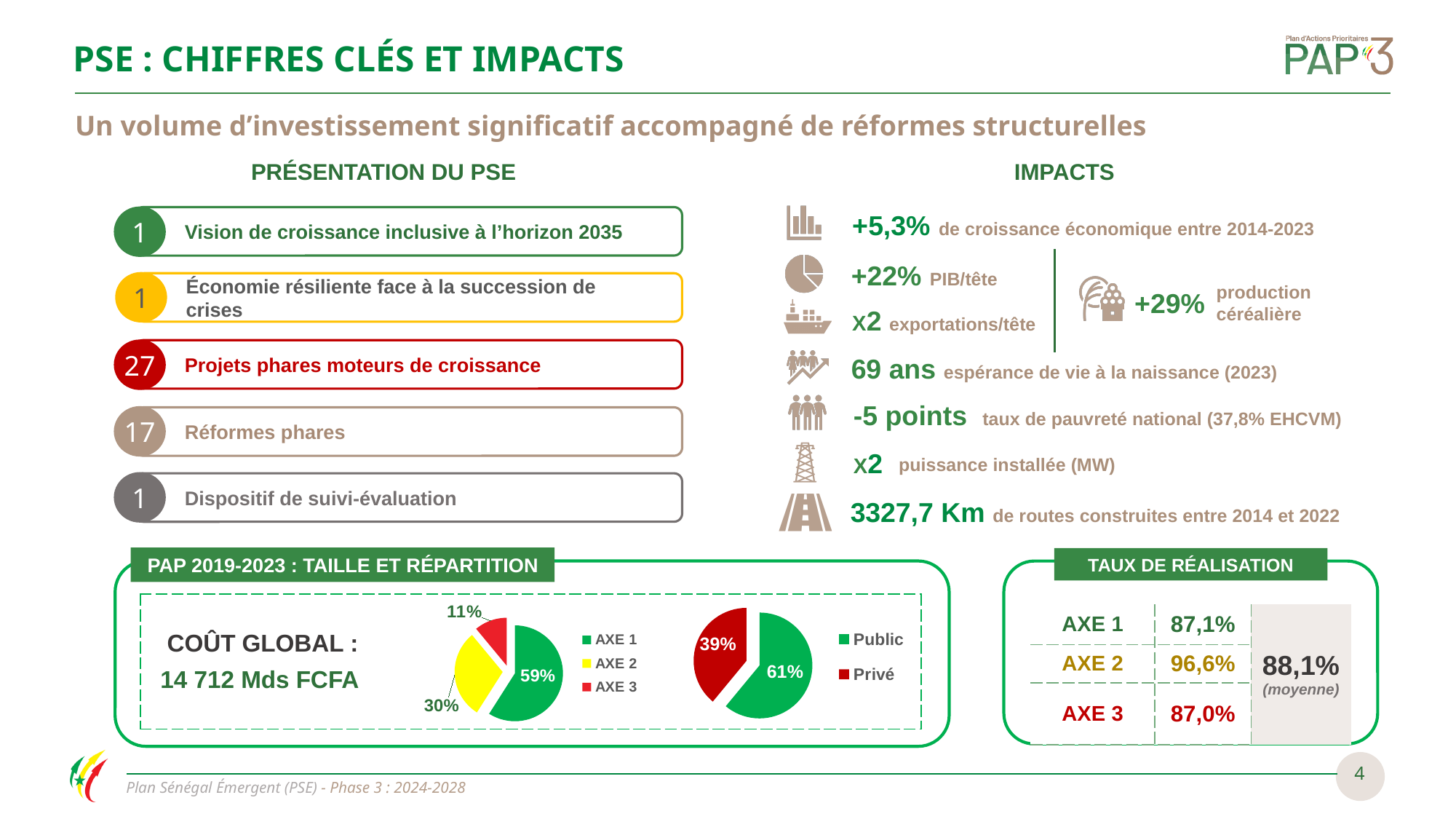
In the right pie chart (Public / Privé), what share is Privé? 39% In the left pie chart under 'PAP 2019-2023 : TAILLE ET RÉPARTITION', what share does AXE 2 have? 30% In the left pie chart (AXE 1 / AXE 2 / AXE 3), what colour is the AXE 2 slice? Yellow In the right pie chart (Public / Privé), which slice is larger, Public or Privé? Public How many slices does the left pie chart (AXE 1 / AXE 2 / AXE 3) have? 3 In the left pie chart (AXE 1 / AXE 2 / AXE 3), what is the difference in percentage points between AXE 1 and AXE 2? 29 percentage points In the left pie chart (AXE 1 / AXE 2 / AXE 3), which slice is the smallest? AXE 3 In the left pie chart under 'PAP 2019-2023 : TAILLE ET RÉPARTITION', what share does AXE 3 have? 11% In the right pie chart (Public / Privé), what share is Public? 61% In the left pie chart under 'PAP 2019-2023 : TAILLE ET RÉPARTITION', what share does AXE 1 have? 59% What type of chart is used to show the Public / Privé split? Pie chart In the left pie chart (AXE 1 / AXE 2 / AXE 3), which slice is the largest? AXE 1